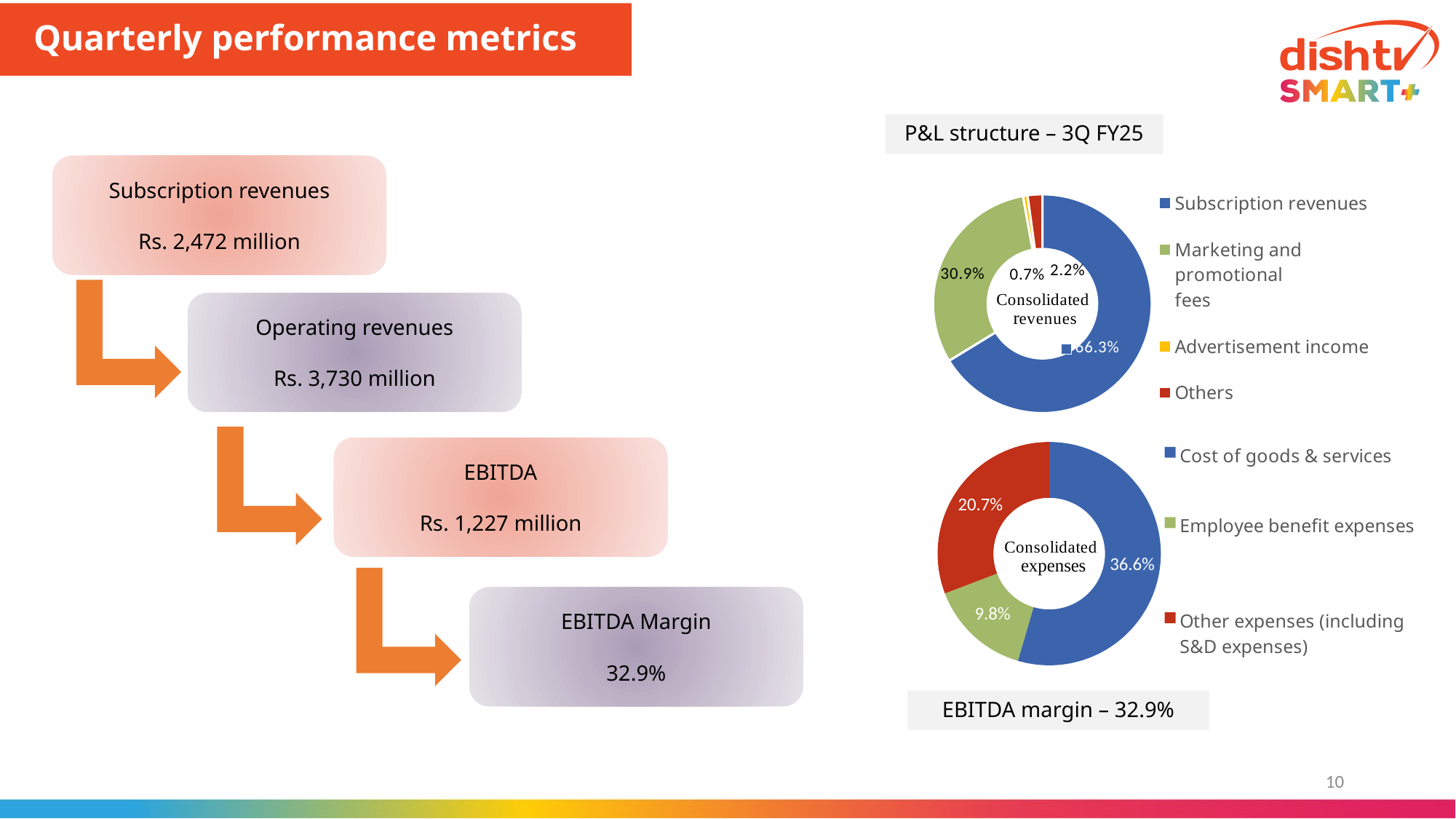
In the Consolidated revenues chart, how many categories does the legend list? 4 In the Consolidated expenses chart, what share is Employee benefit expenses? 9.8% In the Consolidated revenues chart, what share is Others? 2.2% In the Consolidated revenues chart, what share is Advertisement income? 0.7% In the Consolidated expenses chart, what share is Other expenses (including S&D expenses)? 20.7% In the Consolidated revenues chart, which category has the largest share? Subscription revenues In the Consolidated expenses chart, what is the difference between the Other expenses share and the Employee benefit expenses share? 10.9% In the Consolidated revenues chart, what share is Marketing and promotional fees? 30.9% What type of chart is used for the Consolidated expenses? Doughnut (pie) chart In the Consolidated revenues chart, what share is Subscription revenues? 66.3% In the Consolidated expenses chart, what share is Cost of goods & services? 36.6% In the Consolidated revenues chart, which category has the smallest share? Advertisement income